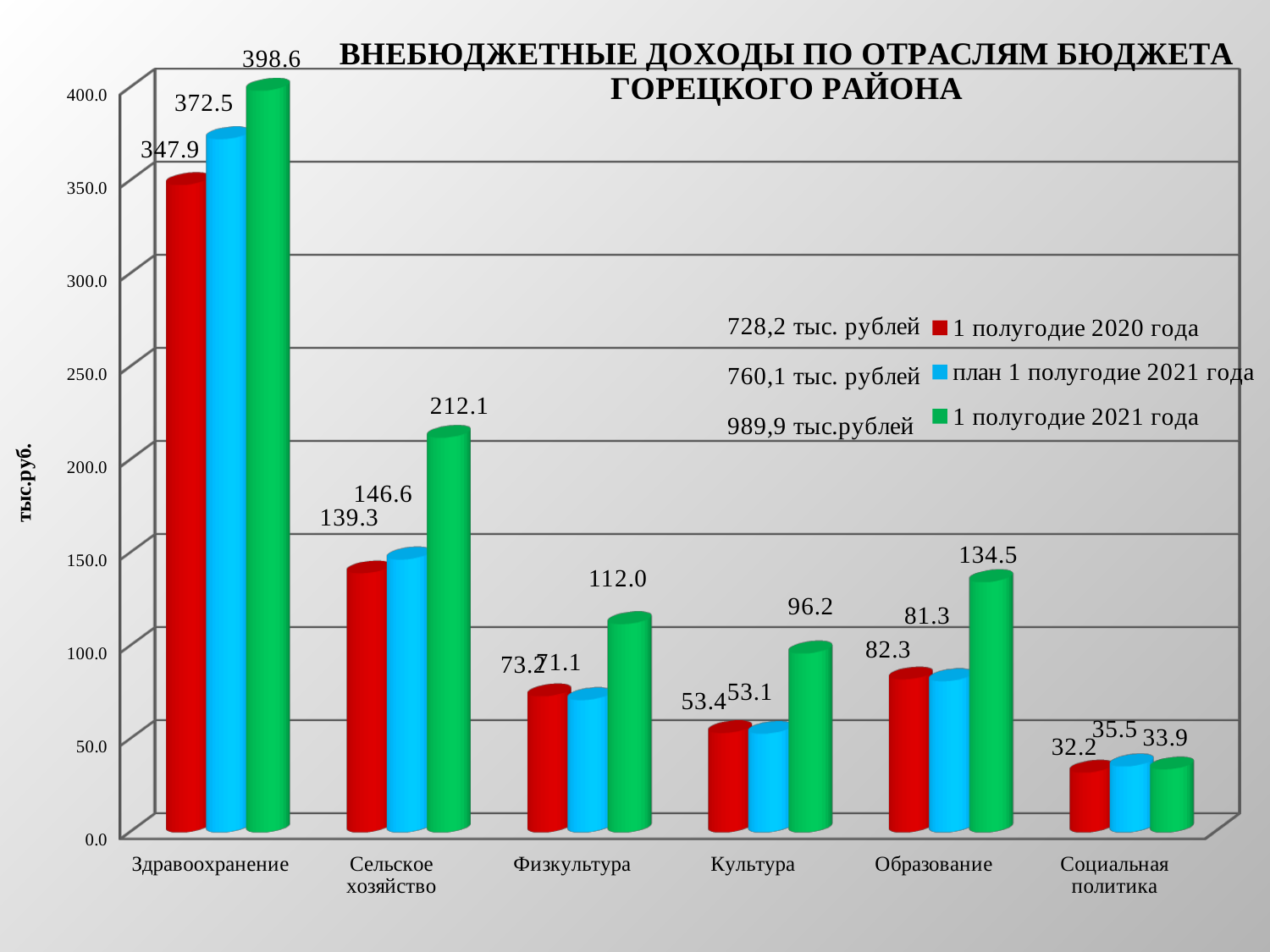
Which category has the lowest value in the series 1 полугодие 2020 года? Социальная политика How many series does the legend list? 3 What is the value for Образование in the series 1 полугодие 2021 года? 134.5 What is the value for Сельское хозяйство in the series 1 полугодие 2020 года? 139.3 Which category has the highest value in the series 1 полугодие 2021 года? Здравоохранение Is the value for Физкультура in the series 1 полугодие 2021 года greater or less than 100? greater What is the value for Здравоохранение in the series 1 полугодие 2021 года? 398.6 Which is larger in the series 1 полугодие 2021 года: Культура or Образование? Образование What kind of chart is shown on the slide? bar chart How many categories are shown on the x axis? 6 What is the difference between the 1 полугодие 2021 года value and the план 1 полугодие 2021 года value for Здравоохранение? 26.1 What is the difference between the 1 полугодие 2021 года value and the 1 полугодие 2020 года value for Сельское хозяйство? 72.8